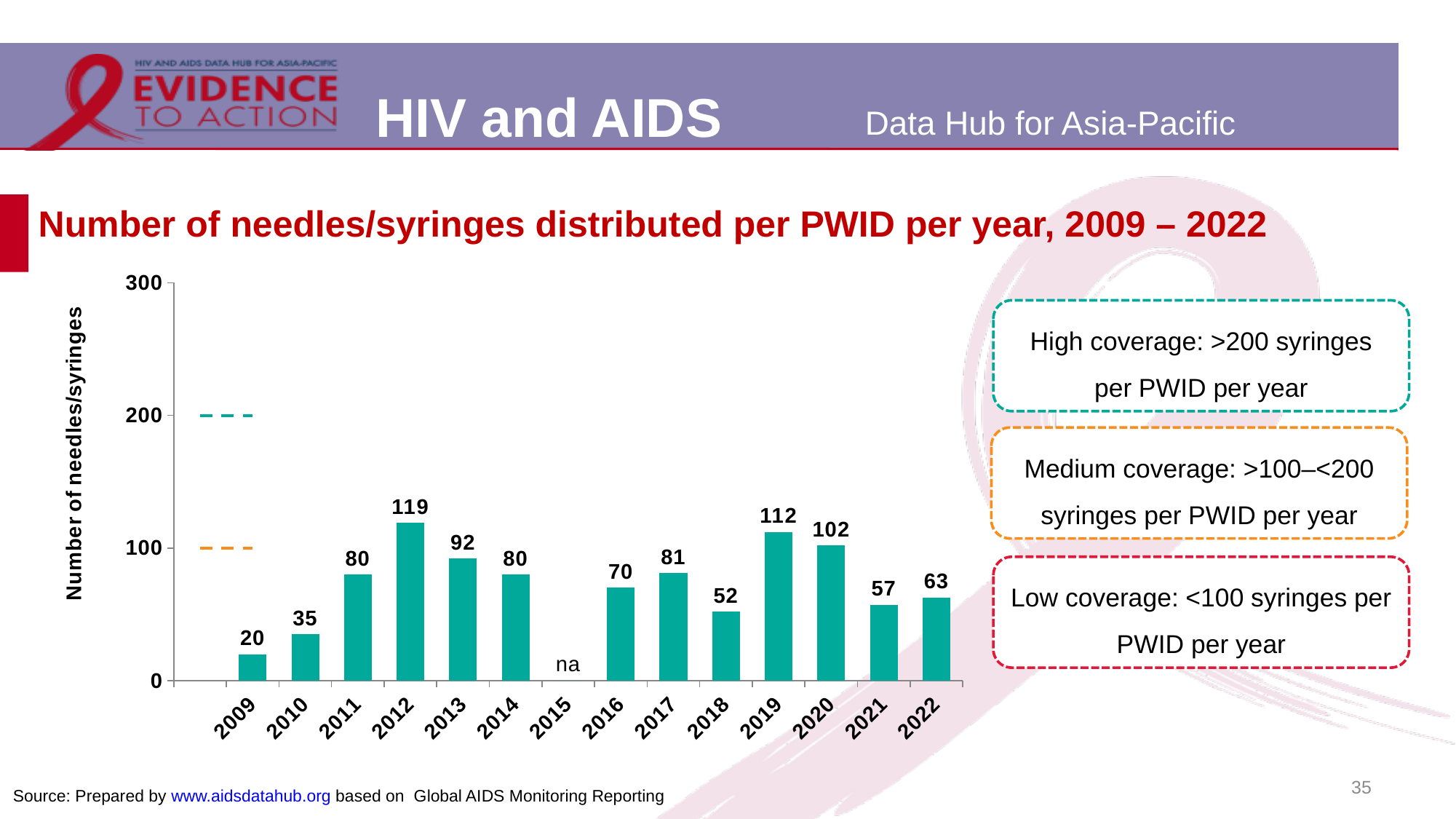
What kind of chart is shown on the slide? bar chart Which year has the lowest plotted value? 2009 Which year has the highest number of needles/syringes distributed per PWID? 2012 Which is larger, the value for 2020 or the value for 2021? 2020 How many years are shown on the x axis? 14 What is the value shown for 2019? 112 What is the difference between the values for 2012 and 2013? 27 What label is shown in place of a bar for 2015? na What is the number of needles/syringes distributed per PWID per year in 2012? 119 What is the value shown for 2009? 20 What is the label of the y axis? Number of needles/syringes Is the value for 2019 greater or less than 100? greater